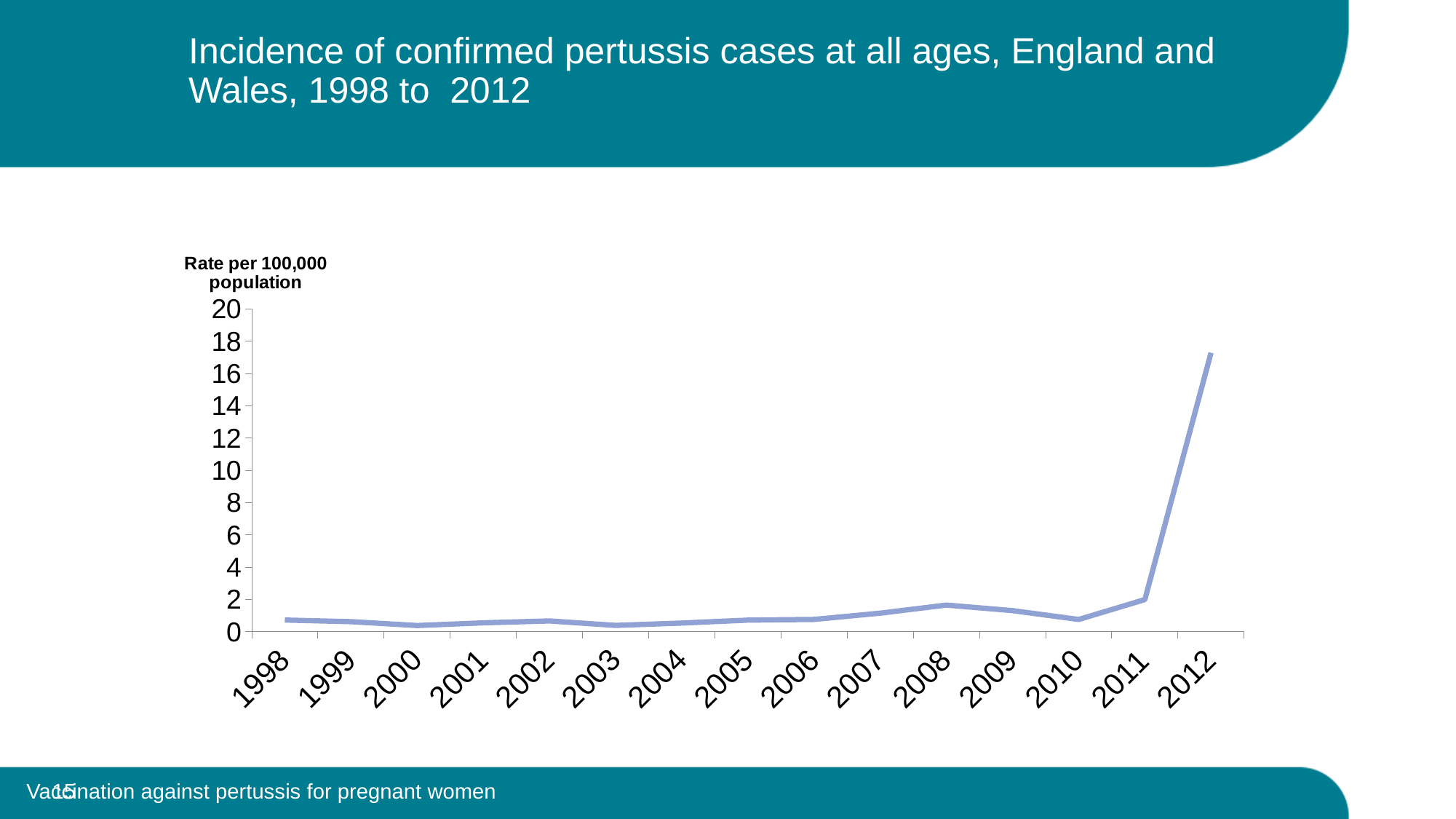
Is the value for 2012 greater or less than 14? greater What is the label on the y axis? Rate per 100,000 population How many years are plotted along the x axis? 15 What is the first year shown on the x axis? 1998 Which year has the larger value, 2011 or 2012? 2012 Does the incidence rate rise or fall between 2011 and 2012? rise Is the value for 2008 greater or less than 4? less Is the value for 2011 greater or less than 4? less Which year has the highest incidence rate? 2012 What kind of chart is shown on the slide? line chart Which year has the larger value, 2008 or 2012? 2012